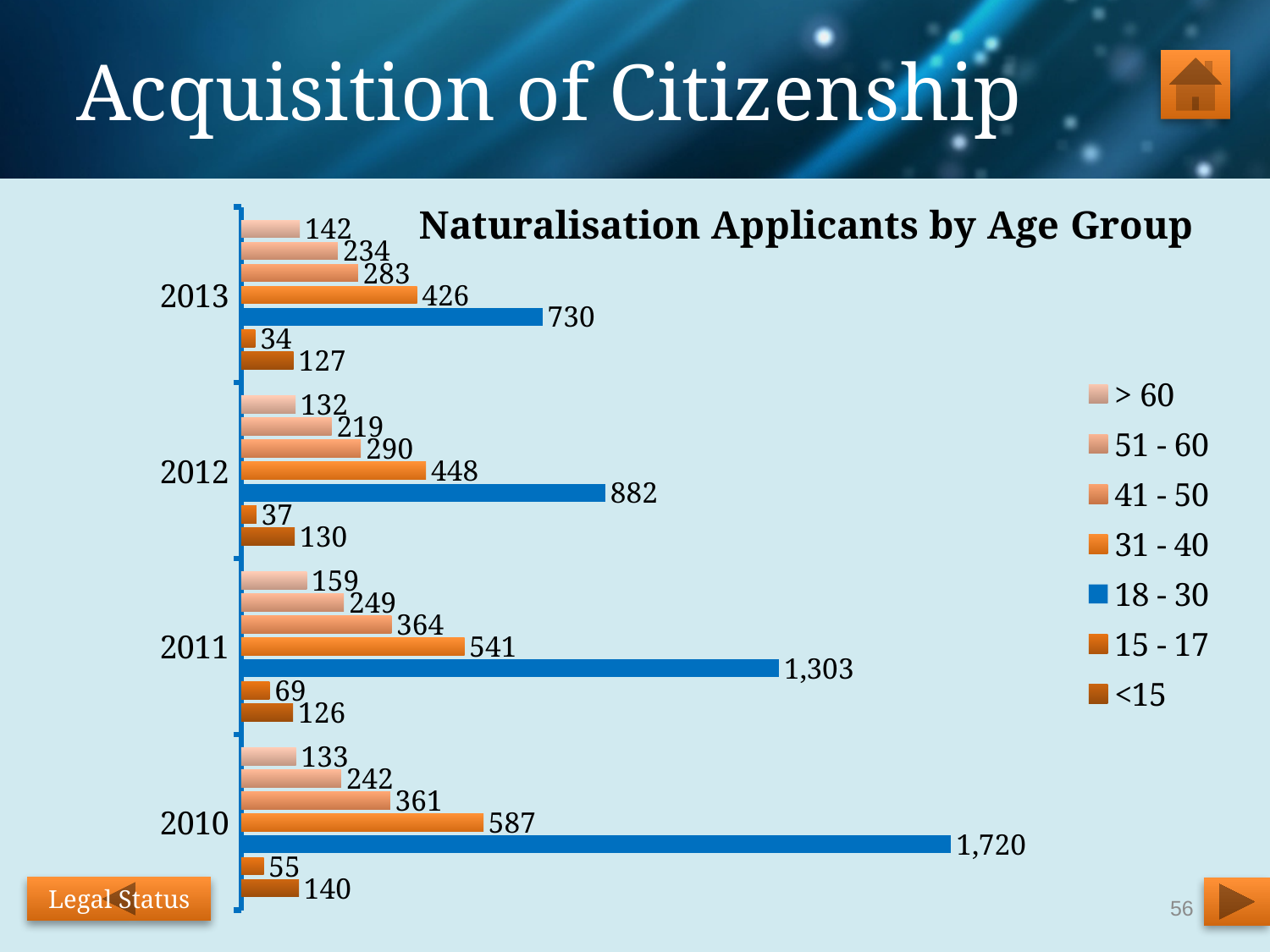
Which age group has the lowest value in 2013? 15 - 17 Which year has the highest value for the 18 - 30 age group? 2010 What is the value for the 18 - 30 age group in 2010? 1,720 What is the title of the chart? Naturalisation Applicants by Age Group Which is larger: the 41 - 50 value in 2010 or in 2011? 2011 What is the difference between the 18 - 30 values for 2011 and 2012? 421 How many age groups does the legend list? 7 How many years are shown on the chart? 4 What is the value for the > 60 age group in 2011? 159 What is the value for the 31 - 40 age group in 2013? 426 What type of chart is shown on the slide? Bar chart What is the value for the <15 age group in 2012? 130